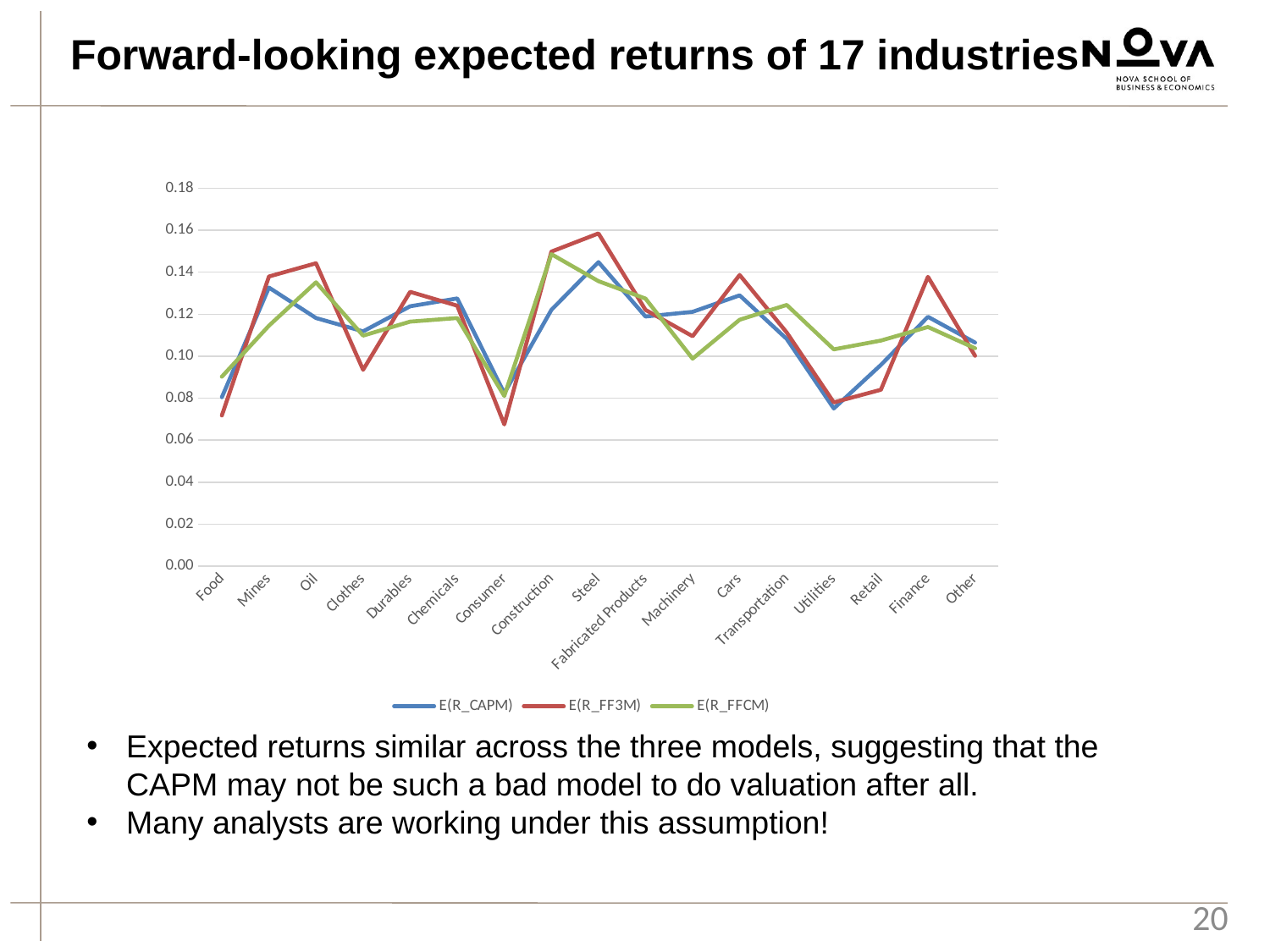
How many series does the legend list? 3 For which industry is the E(R_FF3M) value highest? Steel For Oil, which is larger: the E(R_FF3M) value or the E(R_CAPM) value? E(R_FF3M) What is the title of the chart? Forward-looking expected returns of 17 industries Is the E(R_FF3M) value for Food greater or less than 0.08? less For which industry is the E(R_CAPM) value lowest? Utilities For Clothes, which is larger: the E(R_FFCM) value or the E(R_FF3M) value? E(R_FFCM) How many industries (categories) are plotted along the x axis? 17 For which industry is the E(R_FF3M) value lowest? Consumer Is the E(R_FF3M) value for Steel greater or less than 0.14? greater Which series are listed in the legend? E(R_CAPM), E(R_FF3M), E(R_FFCM) What kind of chart is shown on the slide? line chart